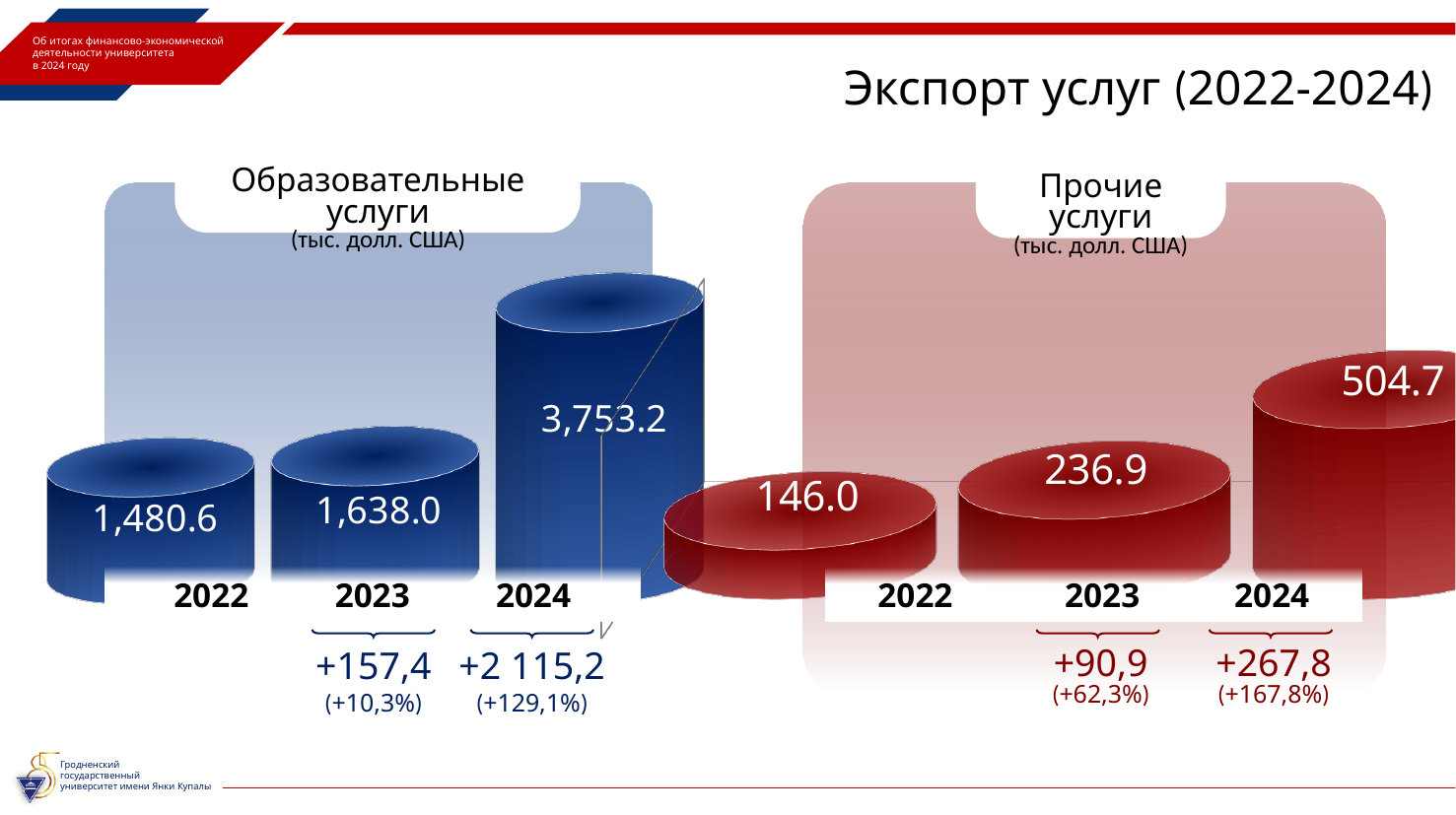
Do the values in the 'Прочие услуги' chart rise or fall from 2022 to 2024? rise In the 'Прочие услуги' chart, which year has the lowest value? 2022 In the 'Прочие услуги' chart, which is larger: the value for 2022 or the value for 2023? 2023 How many years are shown in the 'Образовательные услуги' chart? 3 In the 'Образовательные услуги' chart, what is the value for 2022? 1,480.6 In the 'Прочие услуги' chart, what is the difference between the 2024 and 2023 values? 267.8 In the 'Образовательные услуги' chart, what is the difference between the 2023 and 2022 values? 157.4 In the 'Образовательные услуги' chart, which year has the highest value? 2024 What type of chart is used for 'Образовательные услуги'? bar chart In the 'Прочие услуги' chart, what is the value for 2024? 504.7 In the 'Прочие услуги' chart, what is the value for 2023? 236.9 In the 'Образовательные услуги' chart, what is the value for 2024? 3,753.2